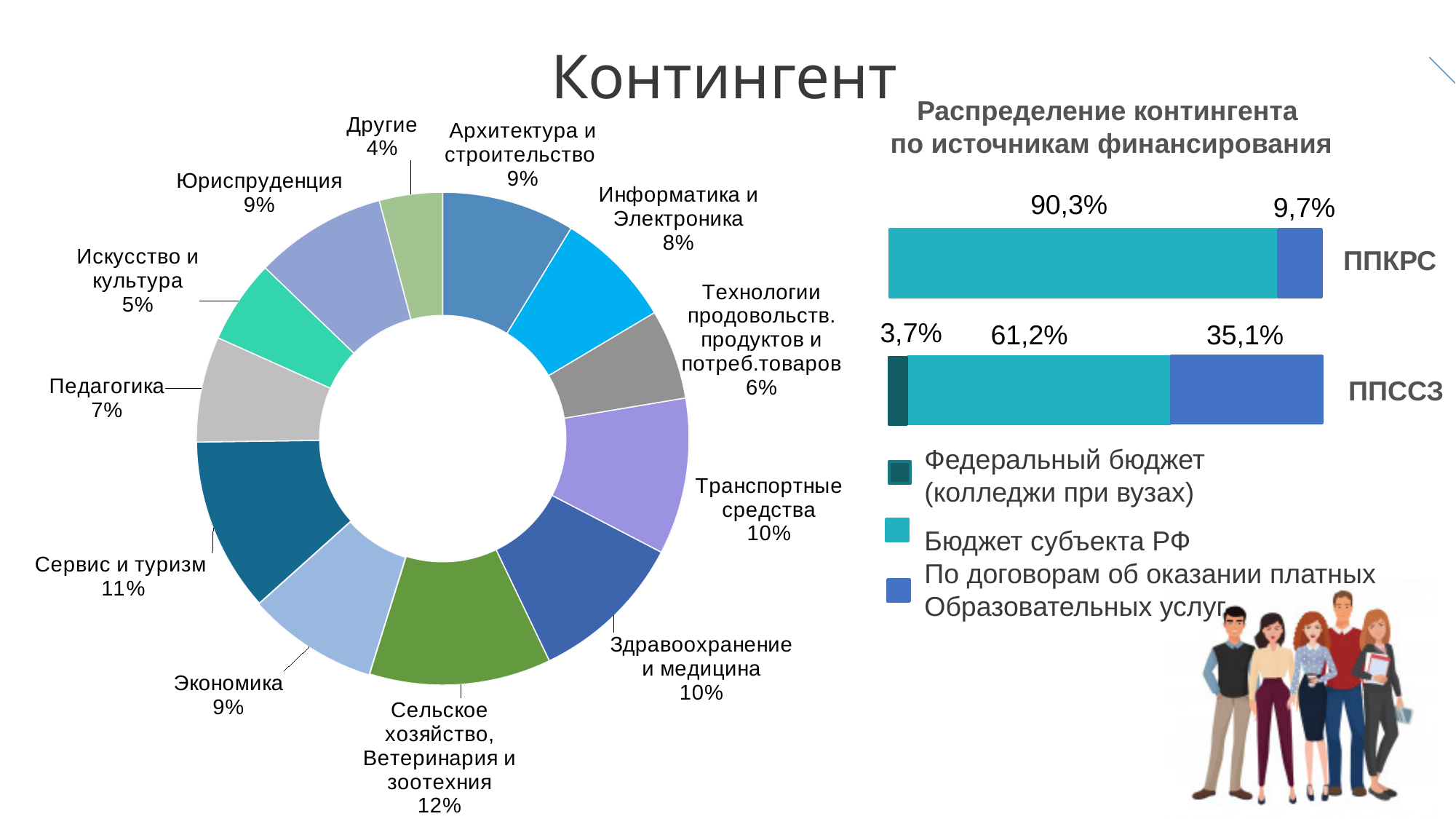
In the donut chart on the left, what share does Сельское хозяйство, Ветеринария и зоотехния have? 12% In the donut chart on the left, what share does Сервис и туризм have? 11% In the donut chart on the left, what is the difference between the shares of Сервис и туризм and Информатика и Электроника? 3% In the chart titled 'Распределение контингента по источникам финансирования', what is the value of Бюджет субъекта РФ for ППКРС? 90,3% In the donut chart on the left, which category has the smallest share? Другие What kind of chart is the one titled 'Распределение контингента по источникам финансирования'? Stacked bar chart In the chart titled 'Распределение контингента по источникам финансирования', how many series does the legend list? 3 In the donut chart on the left, which category has the largest share? Сельское хозяйство, Ветеринария и зоотехния In the donut chart on the left, which is larger: Педагогика or Искусство и культура? Педагогика In the chart titled 'Распределение контингента по источникам финансирования', what is the difference between the По договорам об оказании платных образовательных услуг values for ППССЗ and ППКРС? 25,4% In the donut chart on the left, how many categories are shown? 12 In the chart titled 'Распределение контингента по источникам финансирования', what is the value of Федеральный бюджет (колледжи при вузах) for ППССЗ? 3,7%